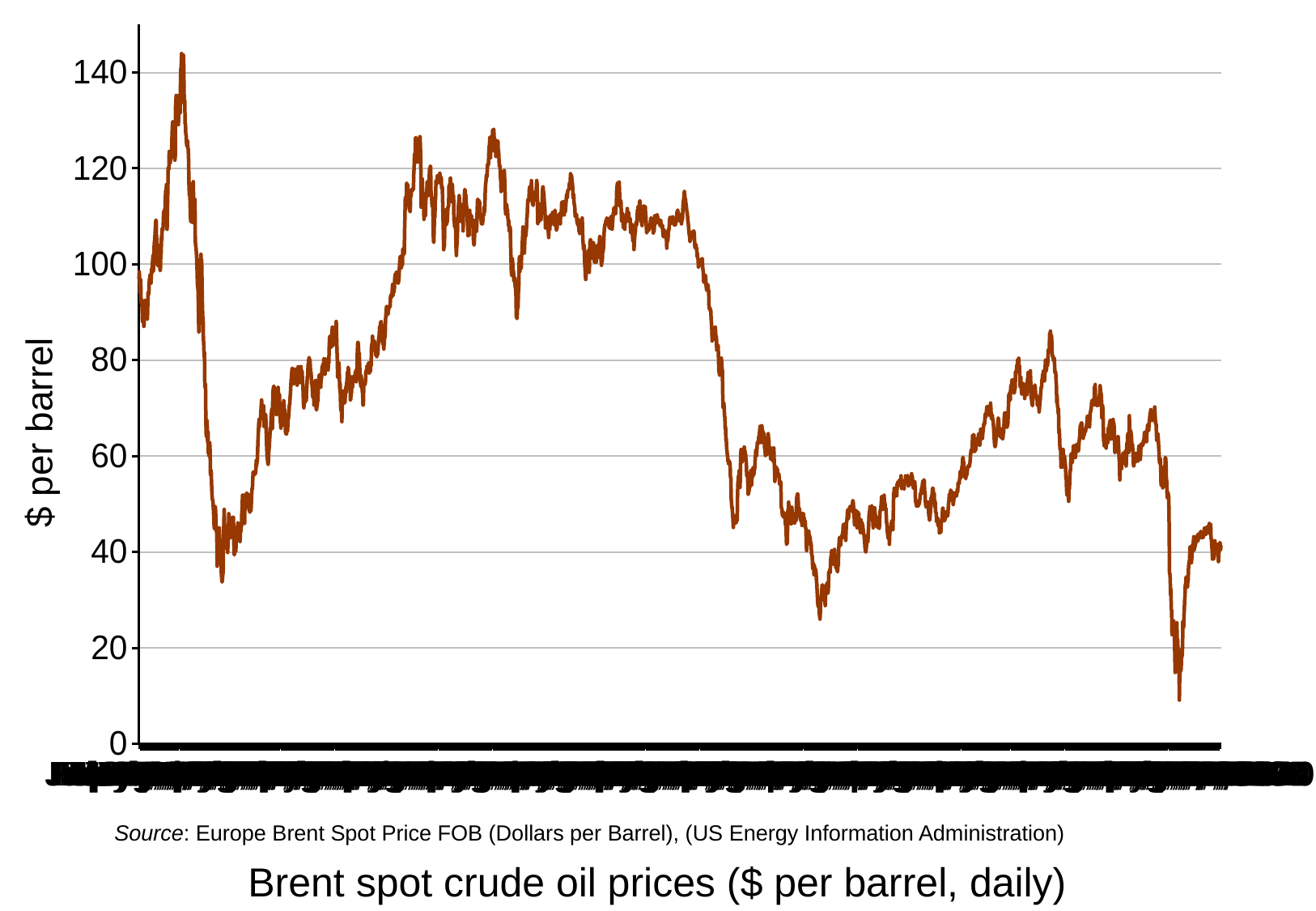
What is the label on the vertical axis of the chart? $ per barrel What kind of chart is shown on the slide? Line chart Is the last value plotted at the right end of the line greater or less than 60? less Is the lowest value reached by the line greater or less than 20? less What is the title of the chart? Brent spot crude oil prices ($ per barrel, daily) Is the highest value reached by the line greater or less than 140? greater Is the value at the left end of the line larger or smaller than the value at the right end? larger How many data series are plotted on the chart? 1 Does the line end higher or lower than where it starts? lower